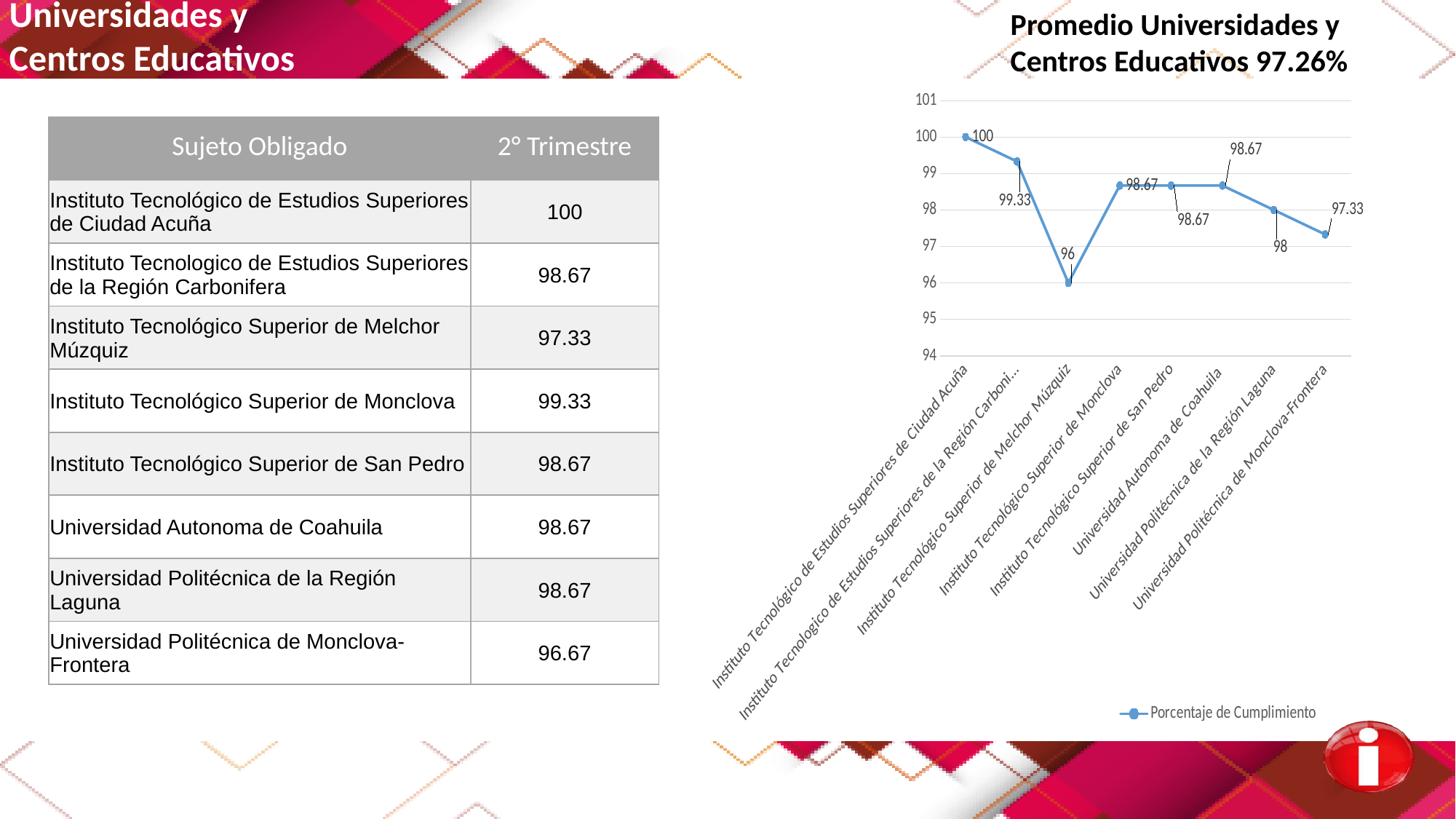
What value does the chart show for Instituto Tecnológico Superior de Melchor Múzquiz? 96 Which category has the lowest value in the chart? Instituto Tecnológico Superior de Melchor Múzquiz What value does the chart show for Instituto Tecnológico de Estudios Superiores de Ciudad Acuña? 100 In the chart, what is the difference between the value for Instituto Tecnológico de Estudios Superiores de Ciudad Acuña and the value for Instituto Tecnológico Superior de Melchor Múzquiz? 4 What value does the chart show for Universidad Politécnica de la Región Laguna? 98 What type of chart is shown on the slide? line chart How many series does the chart legend list? 1 What is the name of the series shown in the chart legend? Porcentaje de Cumplimiento What value does the chart show for Universidad Politécnica de Monclova-Frontera? 97.33 In the chart, which is larger: the value for Instituto Tecnológico Superior de Monclova or the value for Universidad Politécnica de la Región Laguna? Instituto Tecnológico Superior de Monclova How many data points are plotted on the line chart? 8 Which category has the highest value in the chart? Instituto Tecnológico de Estudios Superiores de Ciudad Acuña